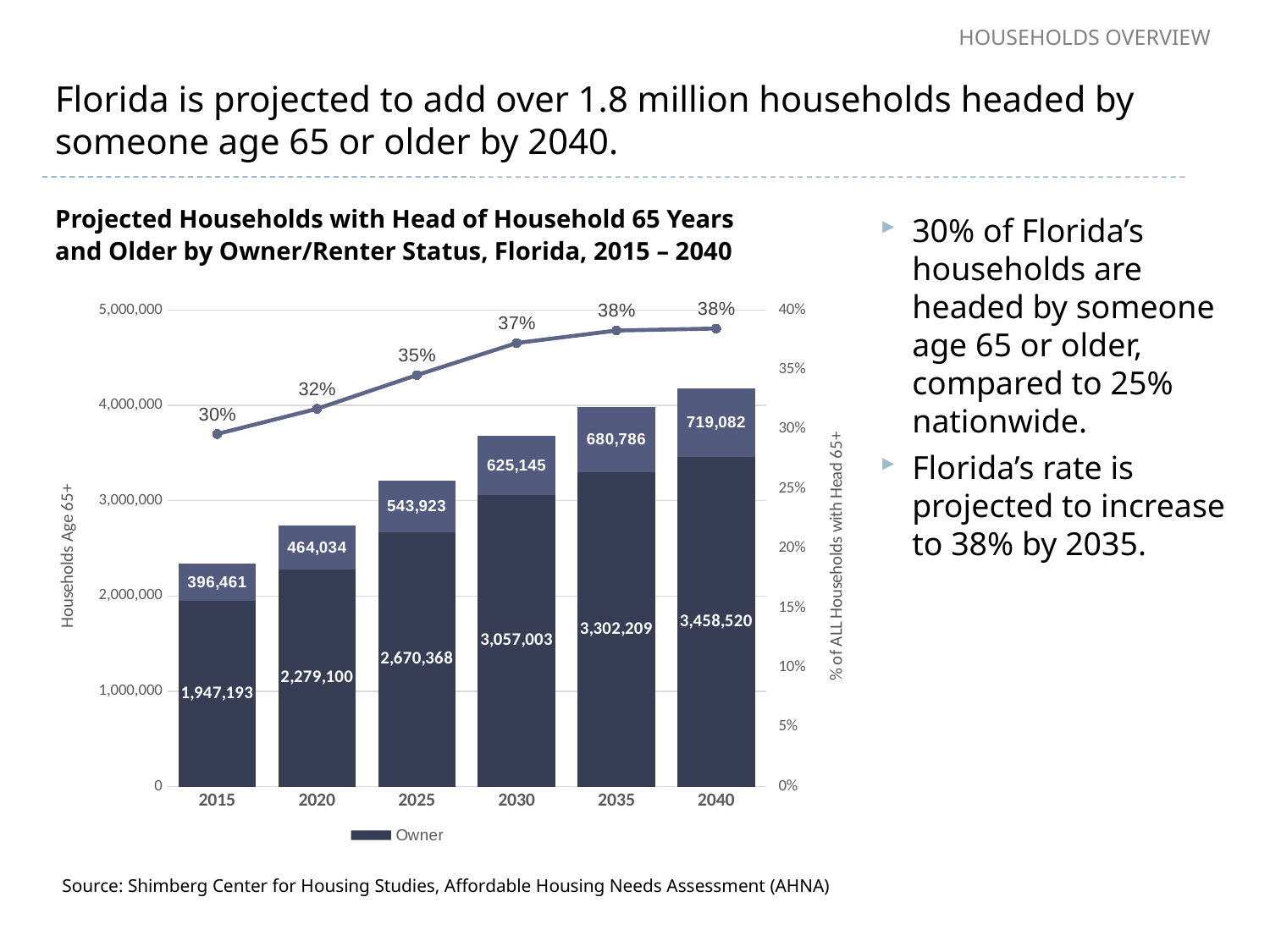
What is the total height of the stacked bar for 2015? 2,343,654 How many years are shown on the x axis? 6 What is the value of the upper (lighter) bar segment for 2030? 625,145 What is the Owner value for 2040? 3,458,520 What is the total height of the stacked bar for 2040? 4,177,602 What is the Owner value for 2015? 1,947,193 Which year has the lowest value for the upper (lighter) bar segment? 2015 What percentage of all households is shown by the line for 2025? 35% Do the Owner values rise or fall from 2015 to 2040? rise Which is larger, the Owner value for 2025 or the Owner value for 2030? 2030 Which year has the highest Owner value? 2040 What is the difference between the Owner value in 2040 and the Owner value in 2015? 1,511,327